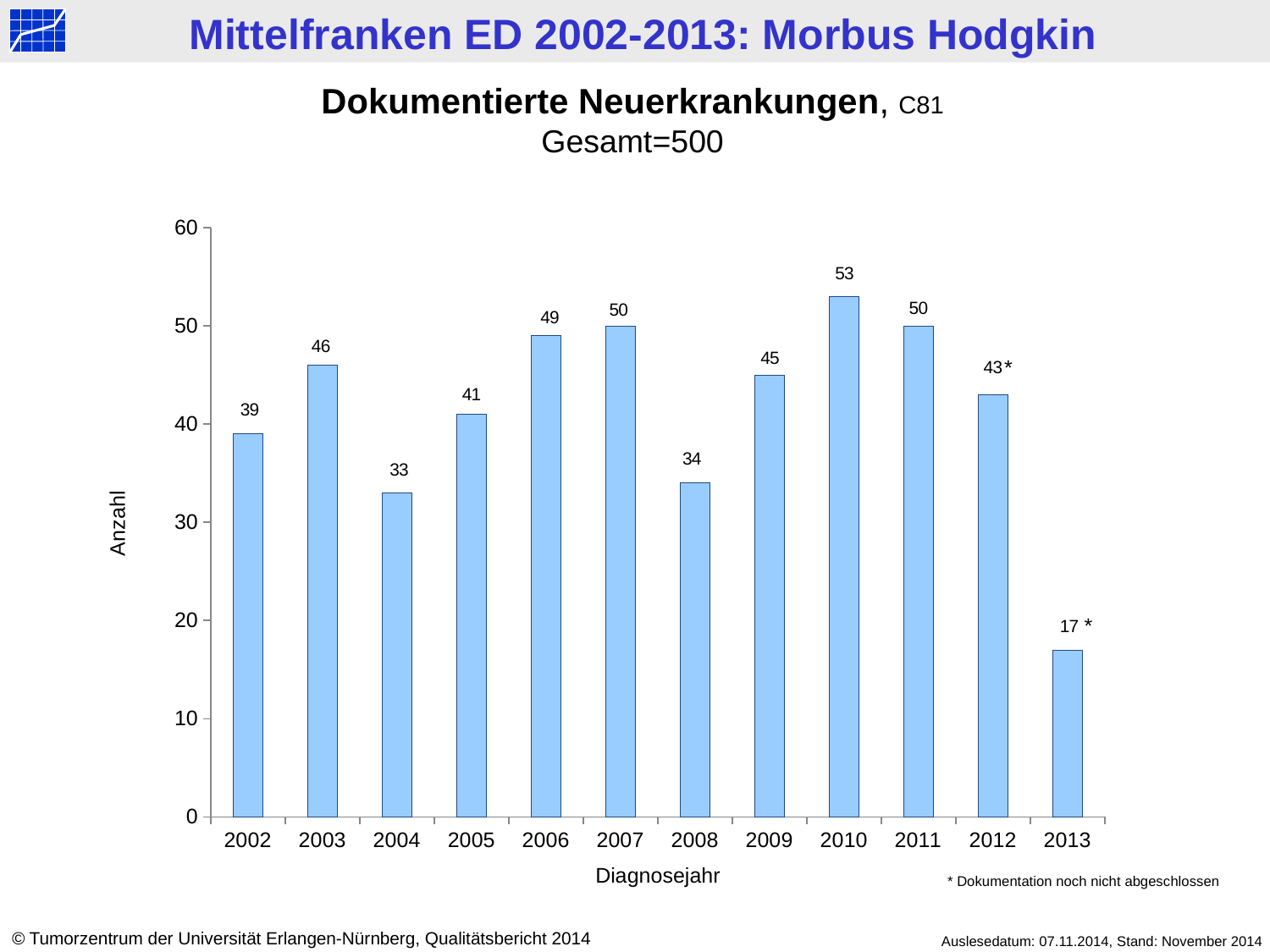
Which year has the larger value, 2003 or 2009? 2003 What is the difference between the values for 2010 and 2004? 20 Which year has the lowest number of documented new cases? 2013 How many years (bars) are shown on the x axis? 12 What is the value shown for 2008? 34 Is the value for 2005 greater or less than 40? greater Do the values rise or fall from 2011 to 2013? Fall What is the label of the y axis? Anzahl What total (Gesamt) is stated in the chart subtitle? 500 What kind of chart is shown on the slide? Bar chart Which year has the highest number of documented new cases? 2010 What is the number of documented new cases (Anzahl) for 2006? 49